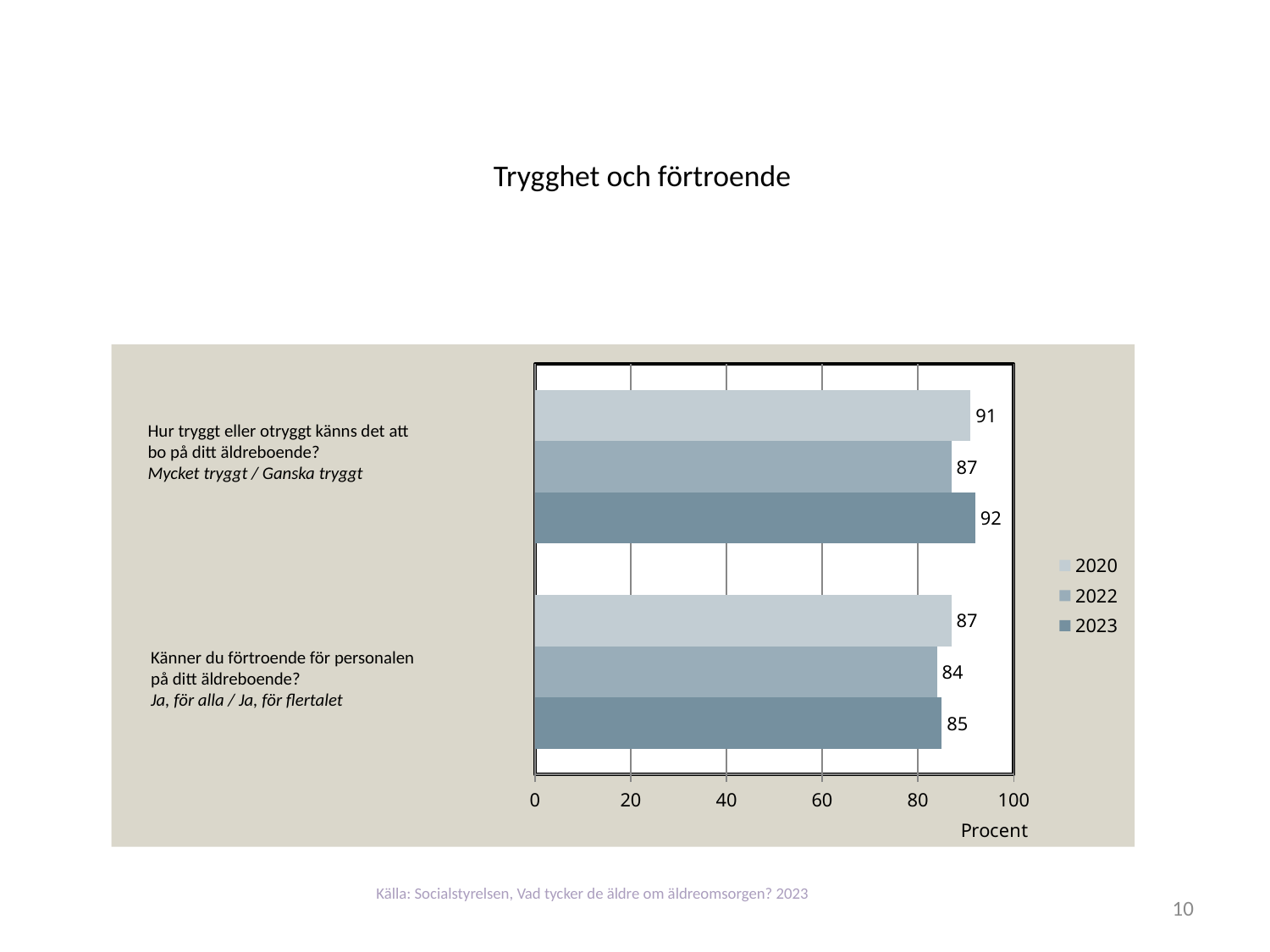
Which is larger: the 2020 value for "Hur tryggt eller otryggt känns det att bo på ditt äldreboende?" or the 2020 value for "Känner du förtroende för personalen på ditt äldreboende?"? Hur tryggt eller otryggt känns det att bo på ditt äldreboende? Which year has the lowest value for "Känner du förtroende för personalen på ditt äldreboende?"? 2022 How many series does the legend list? 3 Which year has the highest value for "Hur tryggt eller otryggt känns det att bo på ditt äldreboende?"? 2023 What is the difference between the 2023 and 2022 values for "Hur tryggt eller otryggt känns det att bo på ditt äldreboende?"? 5 What is the 2023 value for "Hur tryggt eller otryggt känns det att bo på ditt äldreboende?"? 92 What is the 2020 value for "Känner du förtroende för personalen på ditt äldreboende?"? 87 What kind of chart is shown on the slide? Bar chart How many survey questions (categories) are shown in the chart? 2 What is the label on the horizontal axis of the chart? Procent What is the 2022 value for "Känner du förtroende för personalen på ditt äldreboende?"? 84 What is the difference between the 2020 and 2023 values for "Känner du förtroende för personalen på ditt äldreboende?"? 2